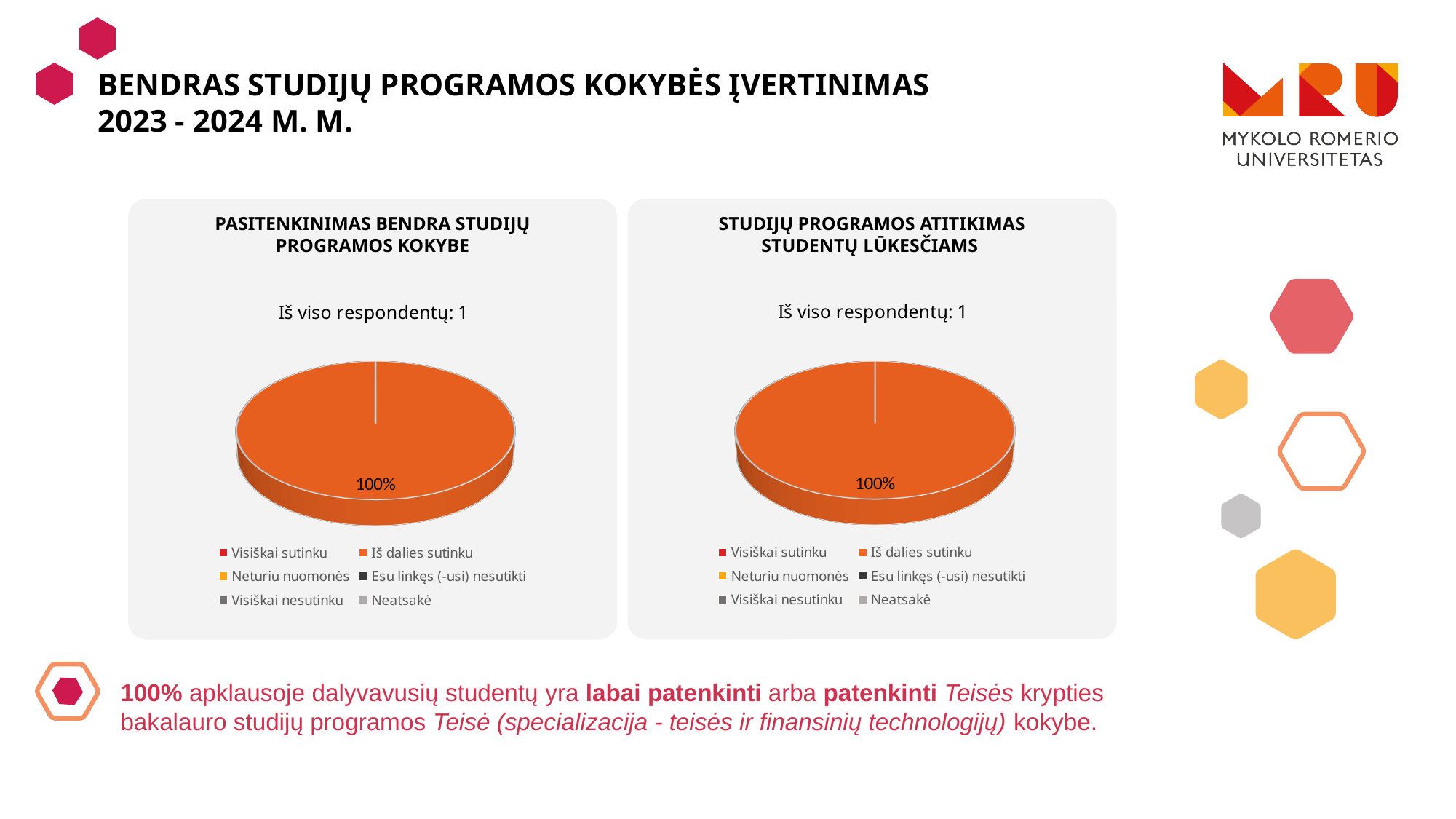
What is the title of the right chart on the slide? Studijų programos atitikimas studentų lūkesčiams In the left chart ("Pasitenkinimas bendra studijų programos kokybe"), what share of the pie does the "Iš dalies sutinku" slice take? 100% What kind of chart is shown under the title "Pasitenkinimas bendra studijų programos kokybe"? Pie chart How many entries does the legend of the right chart ("Studijų programos atitikimas studentų lūkesčiams") list? 6 In the left chart ("Pasitenkinimas bendra studijų programos kokybe"), which legend category is the only one with a visible slice? Iš dalies sutinku In the right chart ("Studijų programos atitikimas studentų lūkesčiams"), which legend category is the only one with a visible slice? Iš dalies sutinku In the right chart ("Studijų programos atitikimas studentų lūkesčiams"), what share of the pie does the "Iš dalies sutinku" slice take? 100% How many respondents are reported for the right chart ("Studijų programos atitikimas studentų lūkesčiams")? 1 How many visible slices does the pie in the right chart ("Studijų programos atitikimas studentų lūkesčiams") have? 1 How many entries does the legend of the left chart ("Pasitenkinimas bendra studijų programos kokybe") list? 6 How many respondents are reported for the left chart ("Pasitenkinimas bendra studijų programos kokybe")? 1 In the left chart ("Pasitenkinimas bendra studijų programos kokybe"), what colour is the legend marker for "Visiškai sutinku"? Red